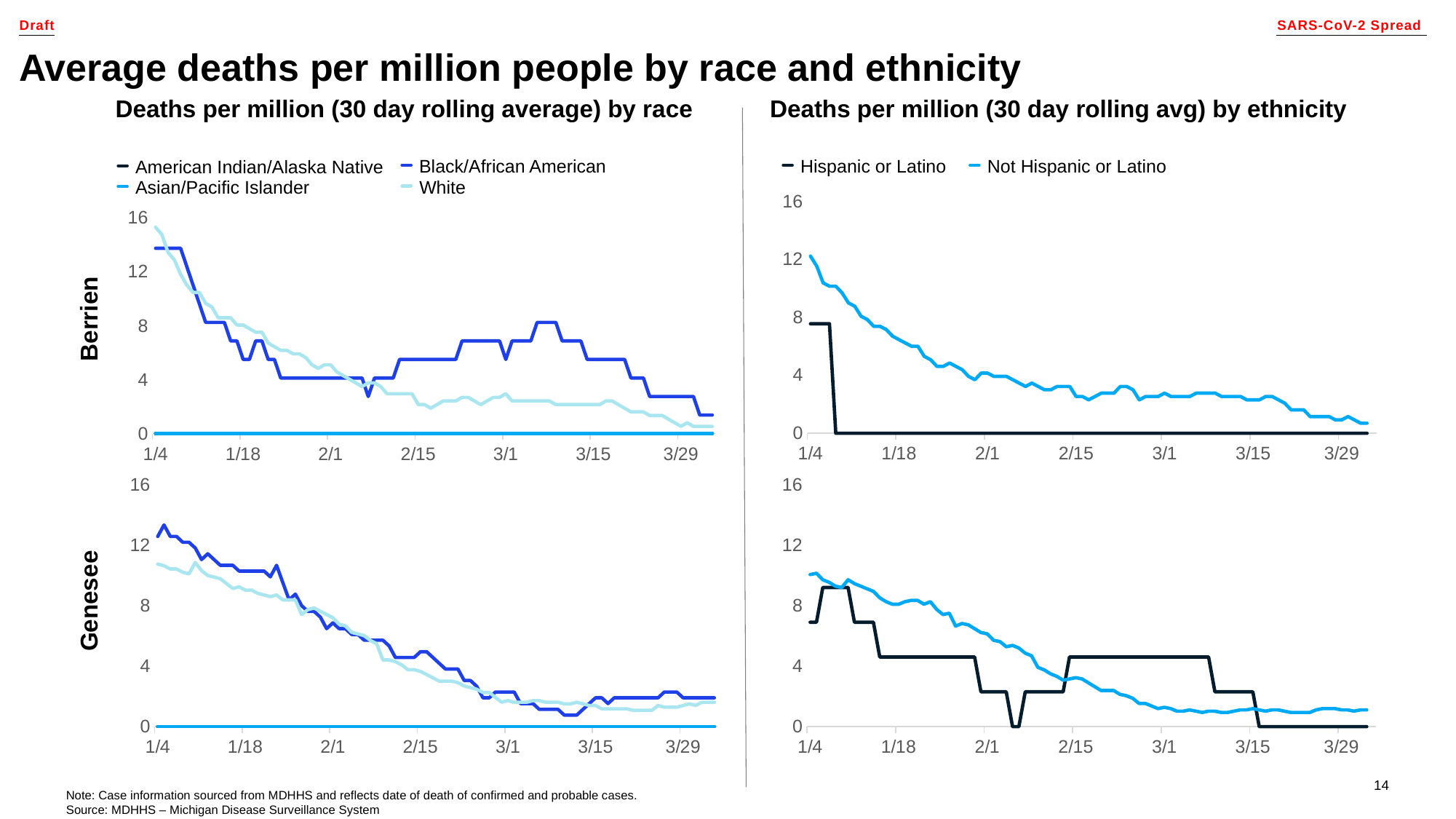
In the Genesee by race chart, does the Black/African American line rise or fall from 1/4 to 3/29? fall In the Berrien by race chart, is the Black/African American value on 1/4 greater or less than 12? greater How many series does the legend of the 'Deaths per million (30 day rolling average) by race' charts list? 4 In the Genesee by ethnicity chart, is the Not Hispanic or Latino value on 1/4 greater or less than 8? greater In the Berrien by ethnicity chart, is the Hispanic or Latino value on 1/4 greater or less than 4? greater In the Berrien by ethnicity chart, does the Not Hispanic or Latino line rise or fall from 1/4 to 3/29? fall How many series does the legend of the 'Deaths per million (30 day rolling avg) by ethnicity' charts list? 2 In the Berrien by race chart, which series has the higher value on 1/4: White or Black/African American? White What kind of chart is the Berrien 'Deaths per million (30 day rolling average) by race' chart? line chart In the Genesee by ethnicity chart, which series has the higher value on 3/29: Hispanic or Latino or Not Hispanic or Latino? Not Hispanic or Latino Which county's charts are shown in the top row of the slide? Berrien